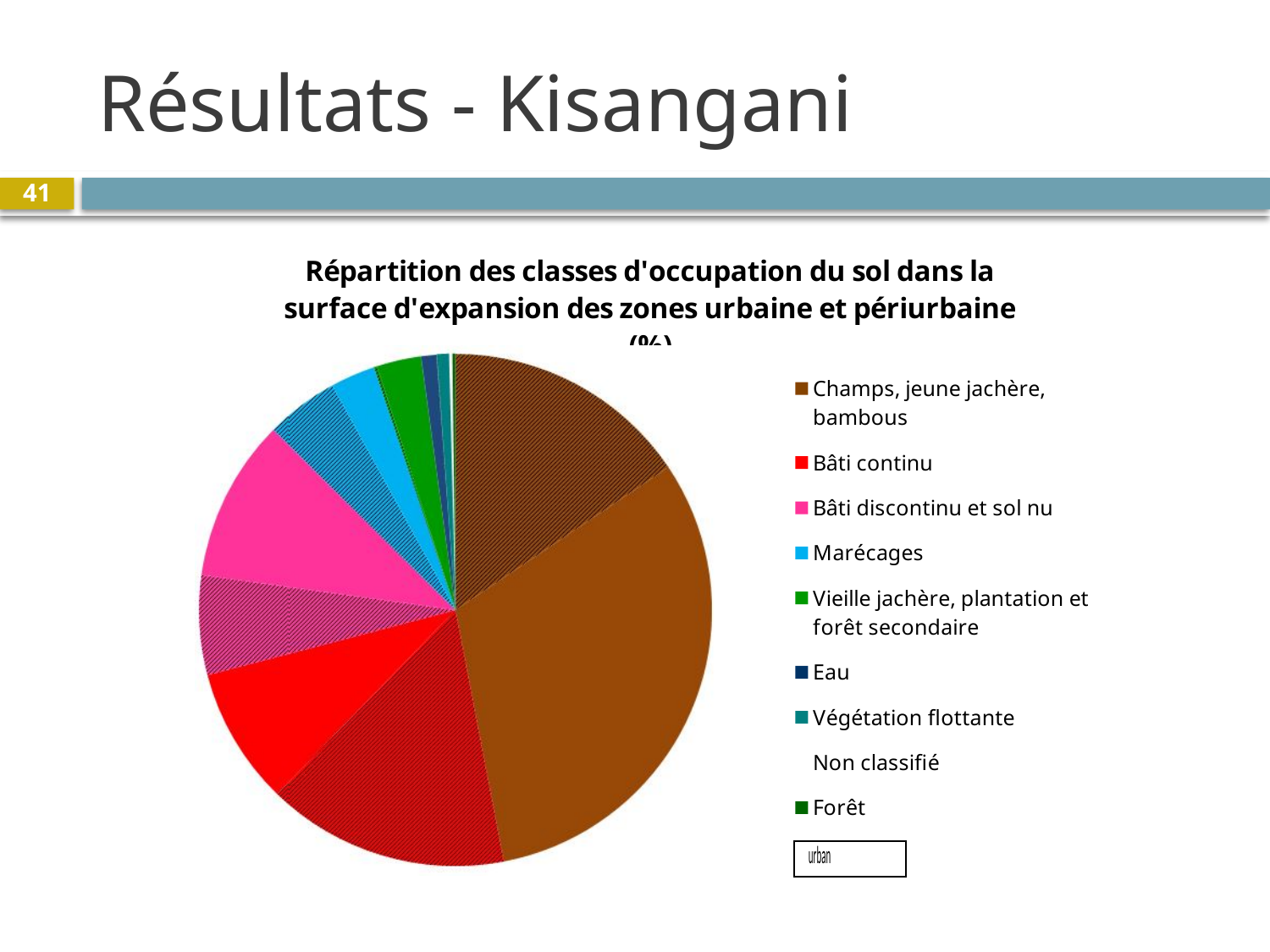
Which category has the larger share of the pie: Bâti continu or Vieille jachère, plantation et forêt secondaire? Bâti continu Which category has the larger share of the pie: Champs, jeune jachère, bambous or Eau? Champs, jeune jachère, bambous What kind of chart is shown on the slide? pie chart What colour represents Bâti continu in the pie chart legend? red Which category has the larger share of the pie: Bâti continu or Marécages? Bâti continu Which category takes the largest share of the pie chart? Champs, jeune jachère, bambous What is the first category listed in the pie chart legend? Champs, jeune jachère, bambous How many categories does the legend of the pie chart list? 9